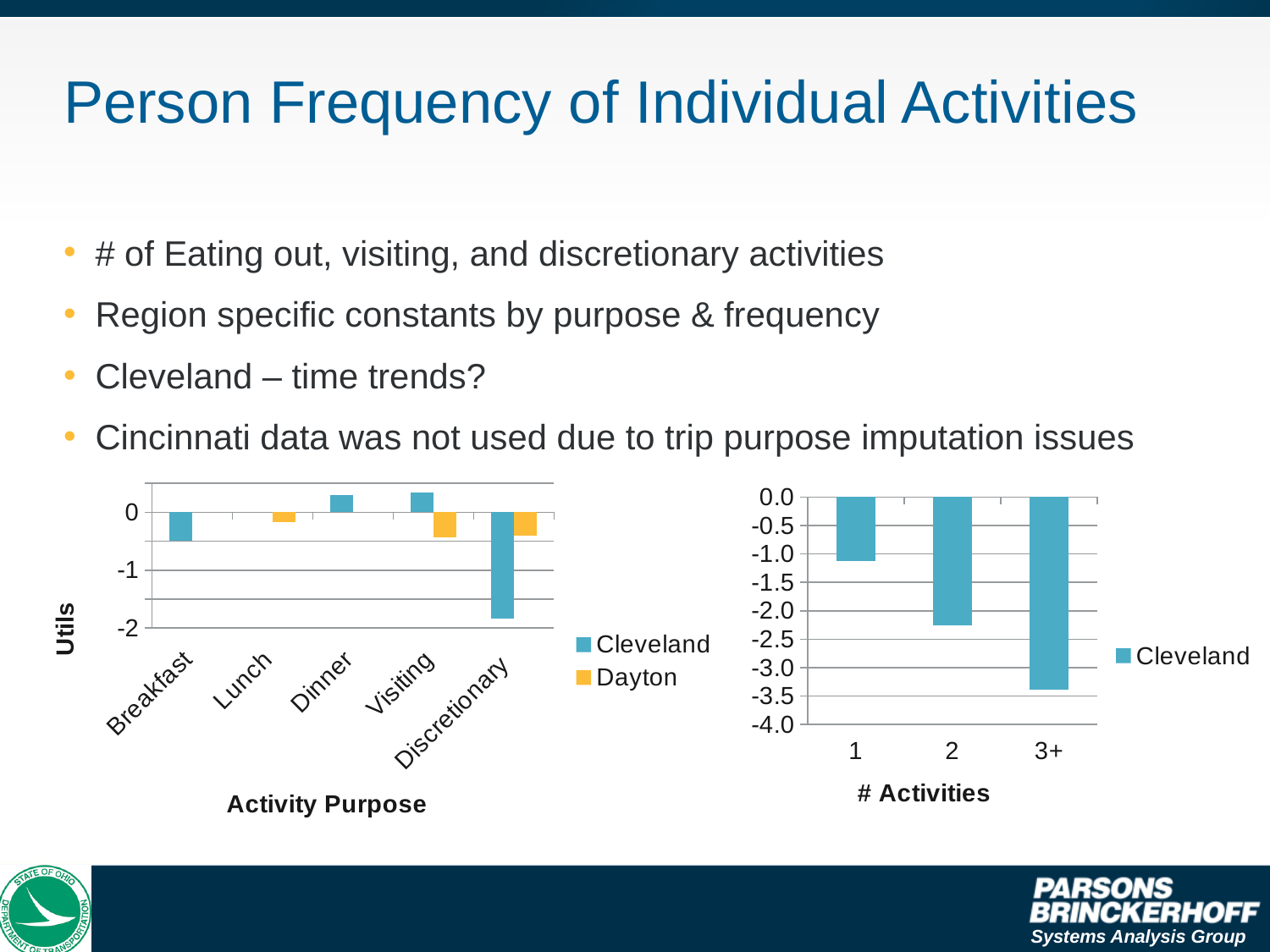
How many series does the legend of the right chart (# Activities) list? 1 In the right chart (# Activities), which is larger, the Cleveland value for 1 or for 2? 1 What is the y-axis title of the left chart (Activity Purpose)? Utils How many series does the legend of the left chart (Activity Purpose) list? 2 How many categories are shown on the x-axis of the right chart (# Activities)? 3 In the left chart (Activity Purpose), is the Cleveland value for Discretionary greater or less than -1? less How many categories are shown on the x-axis of the left chart (Activity Purpose)? 5 In the right chart (# Activities), do the Cleveland values rise or fall from 1 to 3+? fall What kind of chart is the left chart with the x-axis 'Activity Purpose'? bar chart In the right chart (# Activities), is the Cleveland value for 3+ greater or less than -3.0? less In the left chart (Activity Purpose), is the Cleveland value for Dinner greater or less than 0? greater In the left chart (Activity Purpose), which category has the lowest Cleveland value? Discretionary